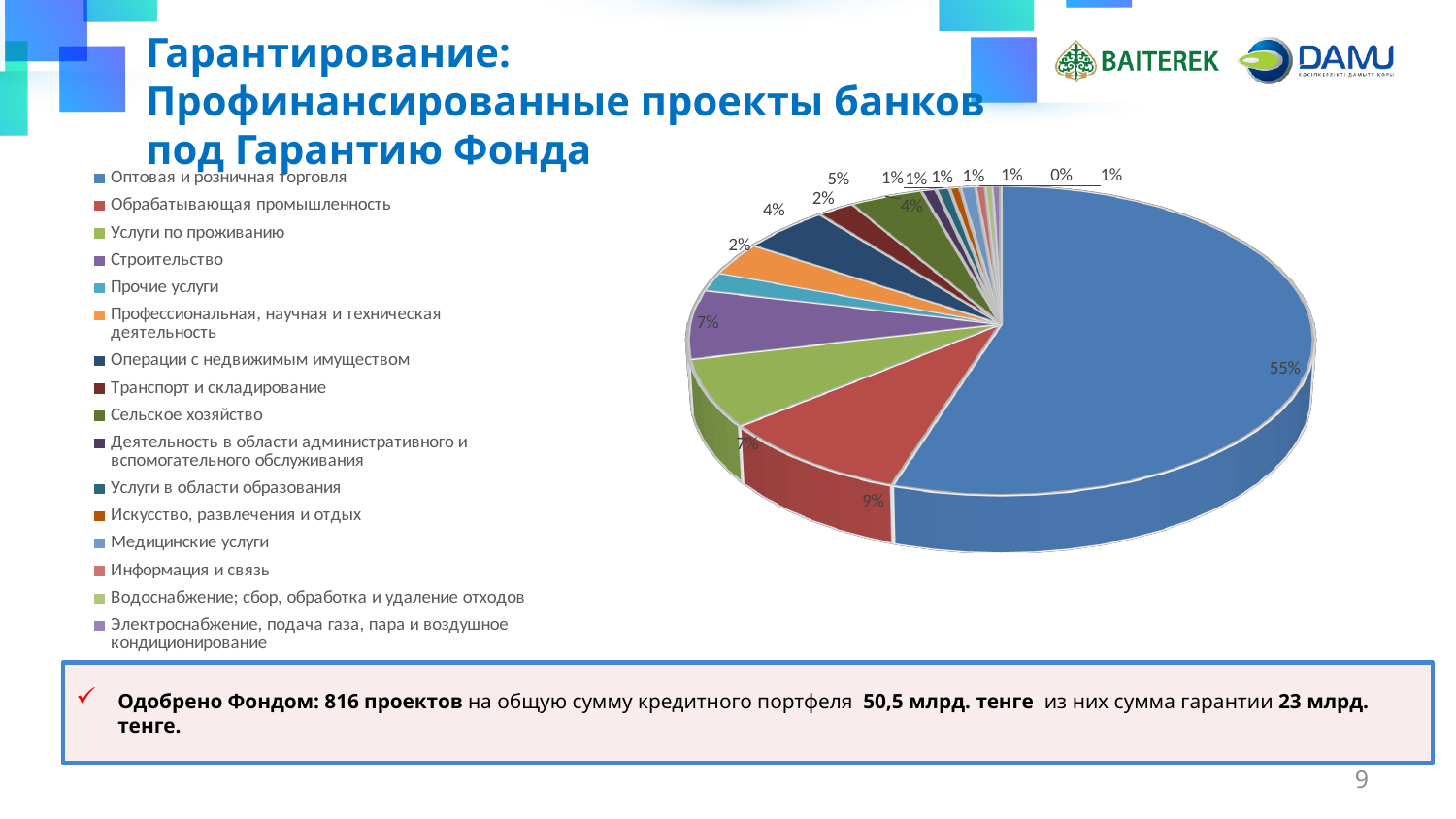
What kind of chart is shown on the slide? pie chart What share of the pie does Операции с недвижимым имуществом have? 5% Which has the larger share: Обрабатывающая промышленность or Операции с недвижимым имуществом? Обрабатывающая промышленность Which category has the largest share of the pie chart? Оптовая и розничная торговля What share of the pie does Обрабатывающая промышленность have? 9% How many categories does the legend of the pie chart list? 16 What is the difference in percentage points between the shares of Оптовая и розничная торговля and Обрабатывающая промышленность? 46 What share of the pie does Профессиональная, научная и техническая деятельность have? 4% What colour is the slice for Оптовая и розничная торговля? blue